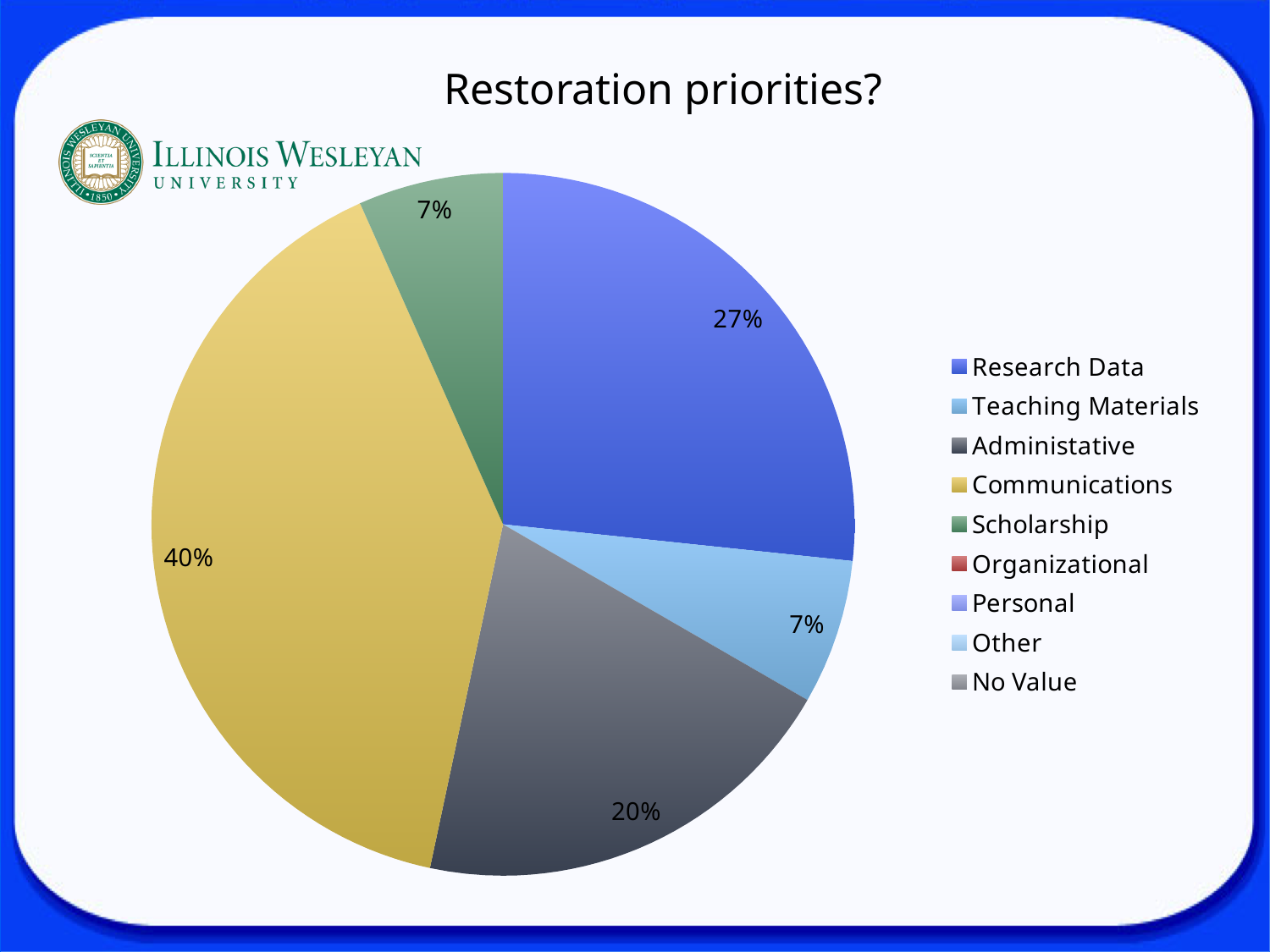
What share of the pie does Communications take? 40% What colour is the Communications slice? yellow Which category has the largest slice of the pie? Communications What is the difference in percentage points between Communications and Research Data? 13 What is the title of the chart? Restoration priorities? What percentage is shown for Scholarship? 7% What percentage is shown for Administative? 20% Which is larger, the slice for Research Data or the slice for Administative? Research Data How many entries does the legend list? 9 What percentage is shown for Research Data? 27% What percentage is shown for Teaching Materials? 7% What type of chart is shown on the slide? pie chart